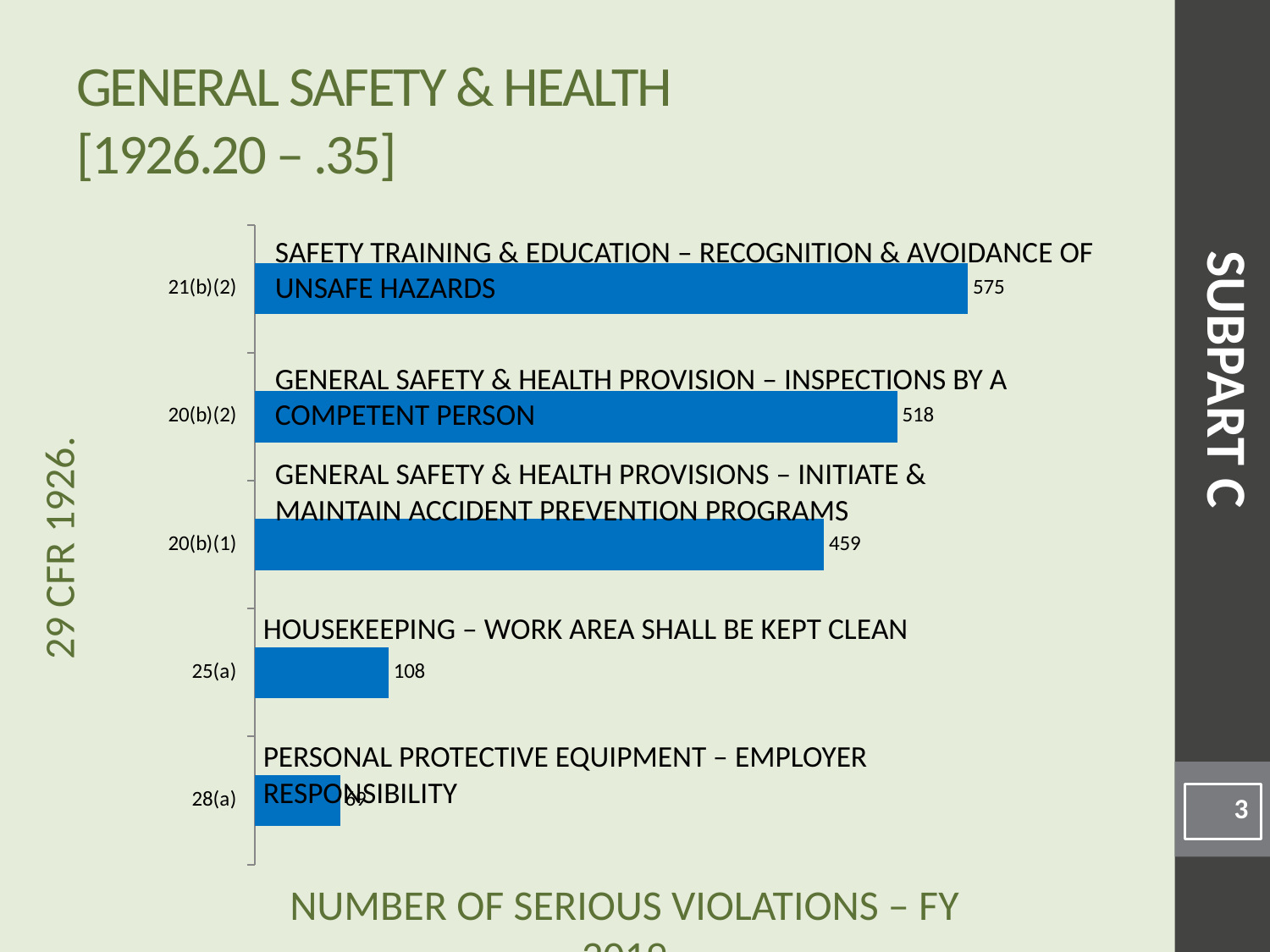
Which standard has the highest number of serious violations? 21(b)(2) What is the difference in serious violations between 20(b)(1) and 25(a)? 351 What is the number of serious violations for 25(a), Housekeeping – work area shall be kept clean? 108 How many standards (categories) are shown in the chart? 5 What type of chart is shown on the slide? Bar chart What is the difference in serious violations between 21(b)(2) and 20(b)(2)? 57 What is the number of serious violations for 20(b)(1)? 459 Which standard has the lowest number of serious violations? 28(a) Which has more serious violations, 20(b)(2) or 20(b)(1)? 20(b)(2) What is the number of serious violations for 21(b)(2)? 575 What colour are the bars in the chart? Blue What is the number of serious violations for 20(b)(2)? 518